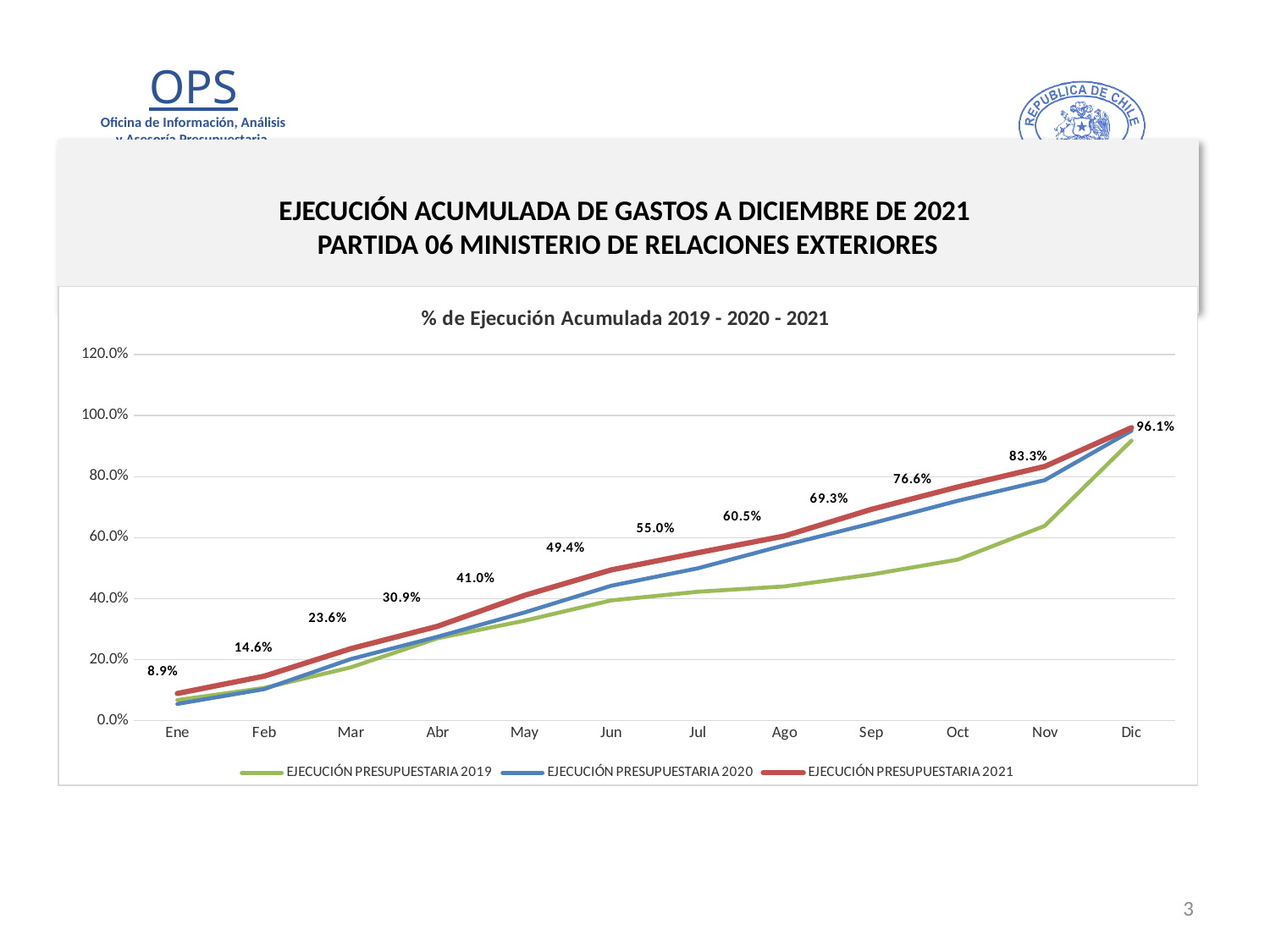
In which month is the EJECUCIÓN PRESUPUESTARIA 2021 value lowest? Ene What is the value labelled for EJECUCIÓN PRESUPUESTARIA 2021 in Ene? 8.9% How many series does the legend list? 3 Is the EJECUCIÓN PRESUPUESTARIA 2019 value for Nov greater or less than 80.0%? less What is the difference between the EJECUCIÓN PRESUPUESTARIA 2021 values for Dic and Nov? 12.8% What type of chart is shown on the slide? Line chart In which month is the EJECUCIÓN PRESUPUESTARIA 2021 value highest? Dic What is the value labelled for EJECUCIÓN PRESUPUESTARIA 2021 in Sep? 69.3% How many months are plotted along the x axis? 12 What is the value labelled for EJECUCIÓN PRESUPUESTARIA 2021 in Jun? 49.4% Do the EJECUCIÓN PRESUPUESTARIA 2021 values rise or fall from Ene to Dic? Rise What is the value labelled for EJECUCIÓN PRESUPUESTARIA 2021 in Dic? 96.1%